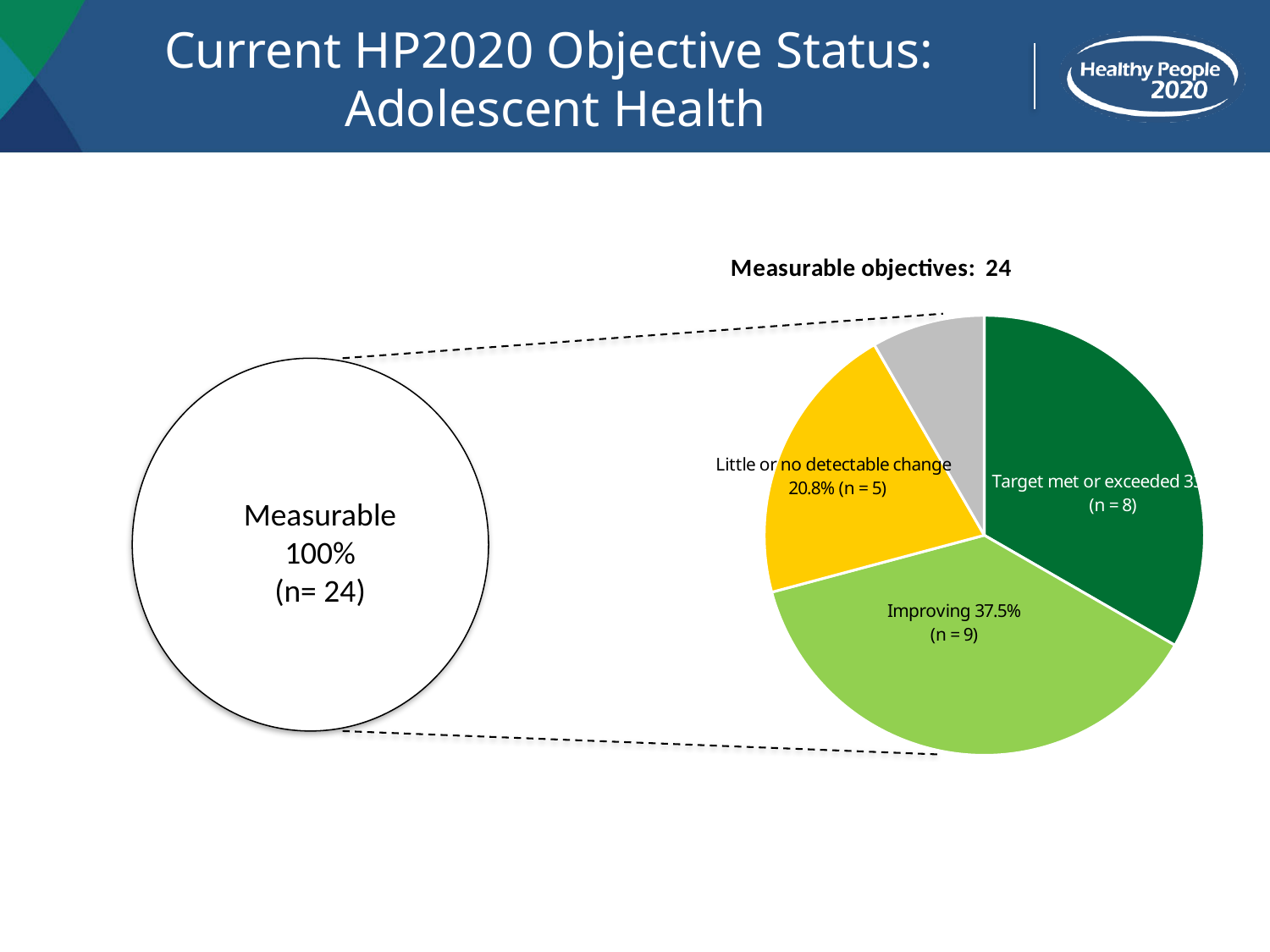
In the right pie chart, what percentage of objectives show Little or no detectable change? 20.8% In the right pie chart, how many more objectives are Improving than show Little or no detectable change? 4 In the right pie chart, how many objectives (n) are in the Little or no detectable change slice? 5 In the right pie chart, what colour is the Improving slice? light green According to the heading above the right pie chart, how many measurable objectives are there? 24 In the right pie chart, how many objectives (n) are in the Target met or exceeded slice? 8 In the right pie chart, what percentage of objectives are labelled Improving? 37.5% In the left circle chart, what percentage of objectives are Measurable? 100% In the right pie chart, which has more objectives: Improving or Little or no detectable change? Improving What kind of chart is shown on the right side of the slide? pie chart In the right pie chart, which labelled category has the most objectives? Improving In the right pie chart, how many objectives (n) are in the Improving slice? 9